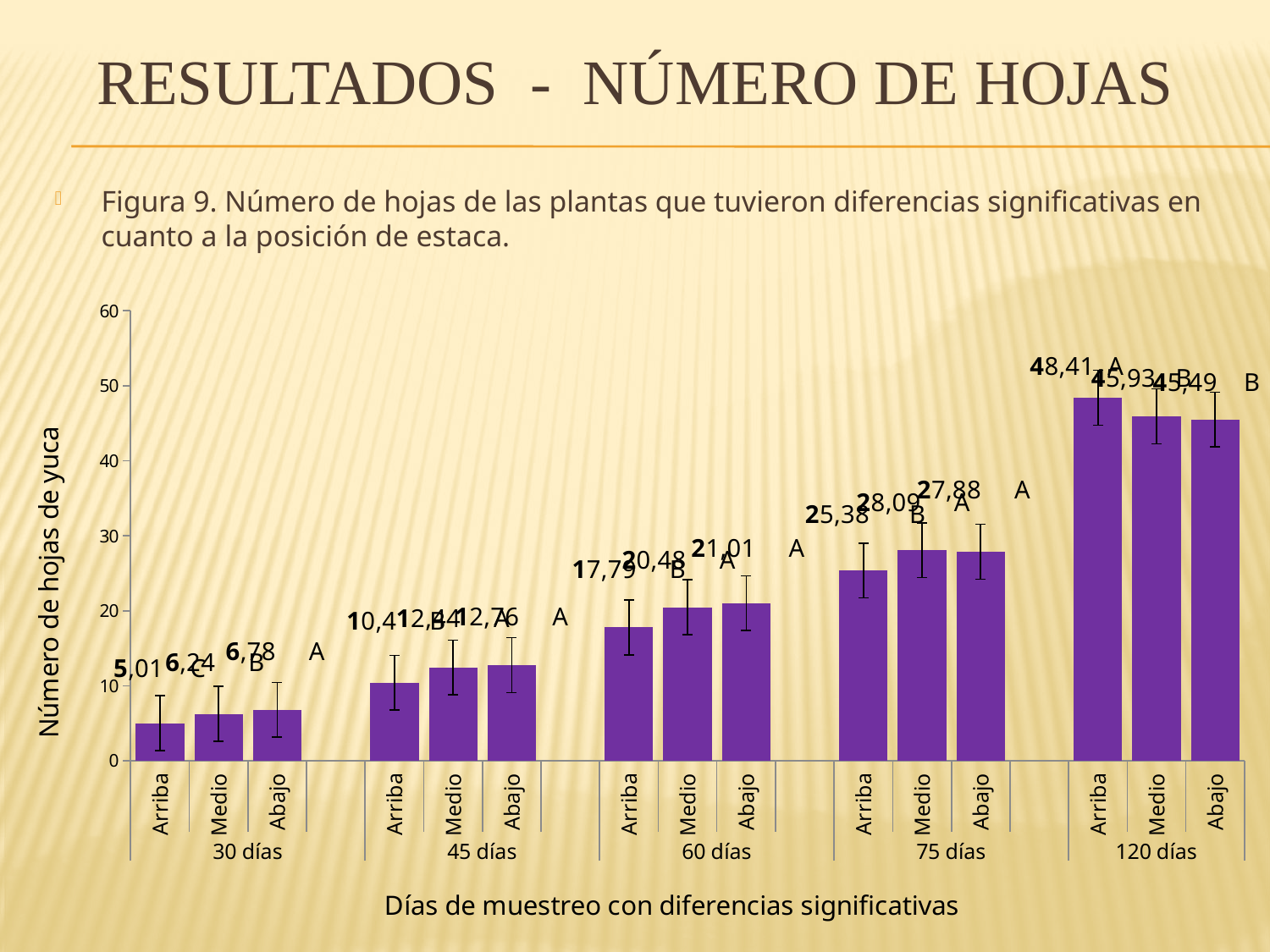
What is the label of the vertical axis? Número de hojas de yuca How many bars are plotted in the chart? 15 Which is larger, Arriba at 60 días or Abajo at 60 días? Abajo at 60 días Which bar has the highest value in the chart? Arriba at 120 días What is the value for Abajo at 30 días? 6,78 What is the value for Medio at 75 días? 28,09 What is the value for Arriba at 30 días? 5,01 What is the value for Arriba at 120 días? 48,41 What kind of chart is shown on the slide? bar chart Is the value for Arriba at 75 días greater or less than 20? greater What is the difference between Arriba at 120 días (48,41) and Medio at 120 días (45,93)? 2,48 Which bar has the lowest value in the chart? Arriba at 30 días